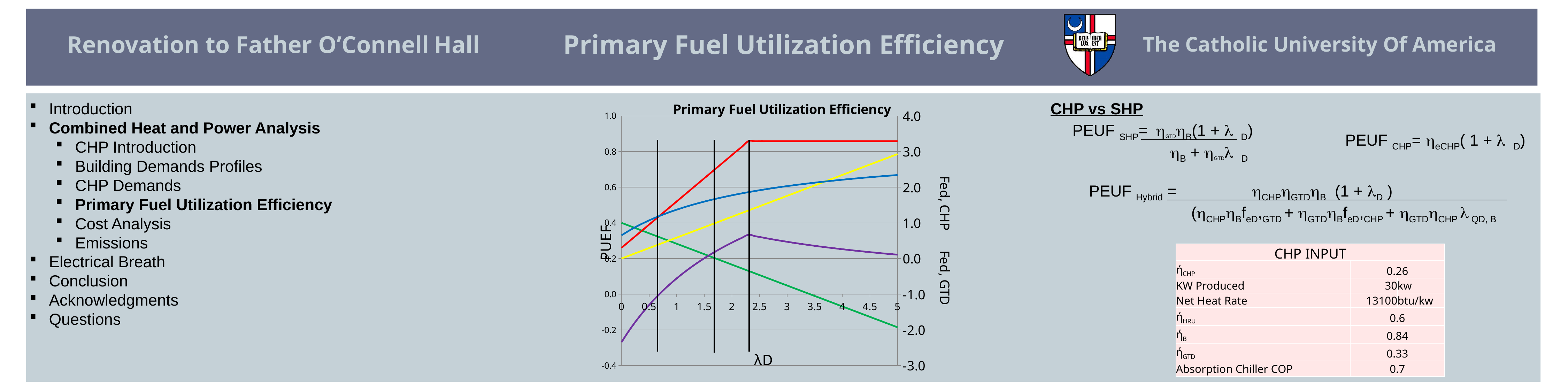
How many coloured data lines are plotted on the chart? 5 At λD = 5, which line is plotted higher on the chart, the red line or the blue line? red line What is the title of the chart? Primary Fuel Utilization Efficiency Does the green line rise or fall as λD increases from 0 to 5? fall What kind of chart is shown on the slide? line chart Does the yellow line rise or fall as λD increases from 0 to 5? rise How many vertical black reference lines are drawn on the chart? 3 What label is shown on the x axis of the chart? λD Read against the left PUEF axis, is the green line at λD = 0 greater or less than 0.6? less Read against the left PUEF axis, is the yellow line at λD = 0 greater or less than 0.4? less Does the purple line rise or fall between λD = 0 and λD = 2? rise Read against the left PUEF axis, is the red line at λD = 5 greater or less than 0.8? greater